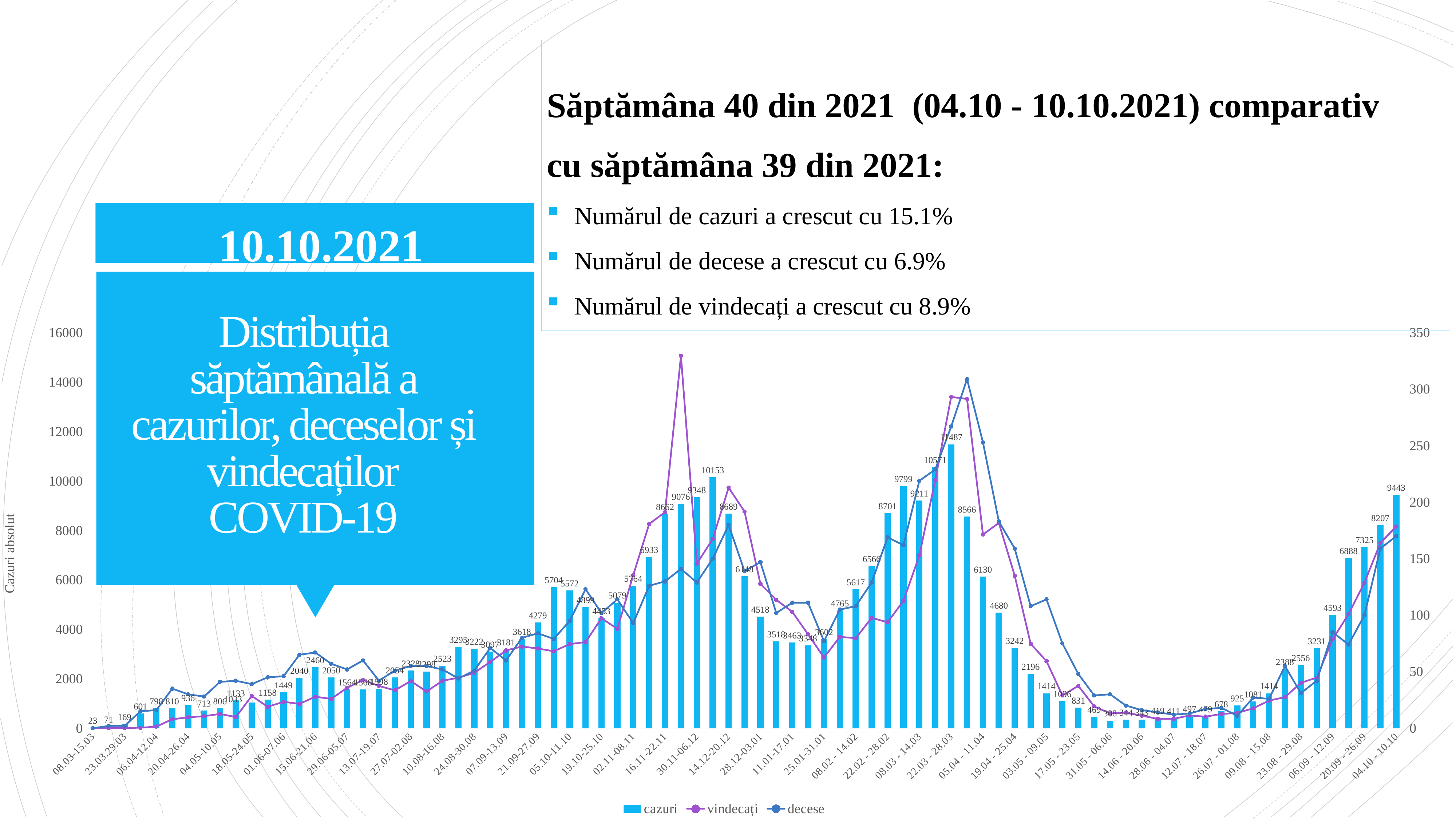
What is the value of the cazuri bar for the week 04.10 - 10.10? 9443 What is the lowest value among the cazuri bars? 23 Which series are listed in the chart legend? cazuri, vindecați, decese What is the value of the cazuri bar for the week 06.09 - 12.09? 4593 What kind of chart is shown on the slide? A combined bar and line chart What is the highest value among the cazuri bars? 11487 How many series does the chart legend list? 3 What is the difference between the cazuri values for 04.10 - 10.10 and 20.09 - 26.09? 2118 Is the decese value for the week 04.10 - 10.10 greater or less than 100 on the right axis? greater Do the cazuri bars rise or fall from the week 09.08 - 15.08 to the week 04.10 - 10.10? rise What is the value of the cazuri bar for the first week, 08.03-15.03? 23 What is the value of the cazuri bar for the week 20.09 - 26.09? 7325